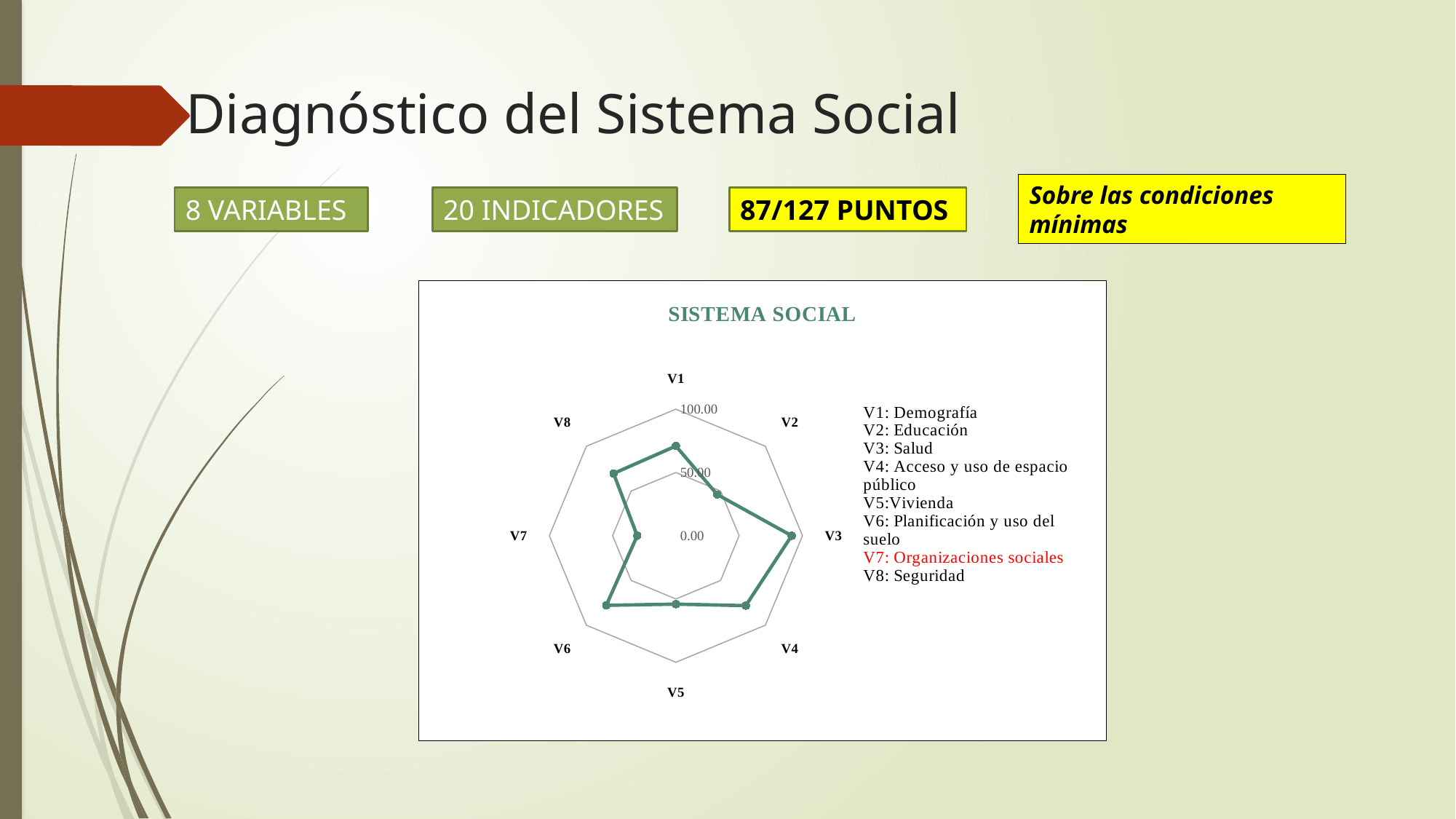
Is the value for V7 greater or less than 50.00? less Is the value for V3 greater or less than 50.00? greater According to the chart's key, what does V7 stand for? Organizaciones sociales Which has the larger value, V1 or V2? V1 Which has the larger value, V3 or V7? V3 How many variables (axes) are plotted on the radar chart? 8 Is the value for V1 greater or less than 50.00? greater What is the title of the chart? SISTEMA SOCIAL What kind of chart is shown on the slide? Radar chart